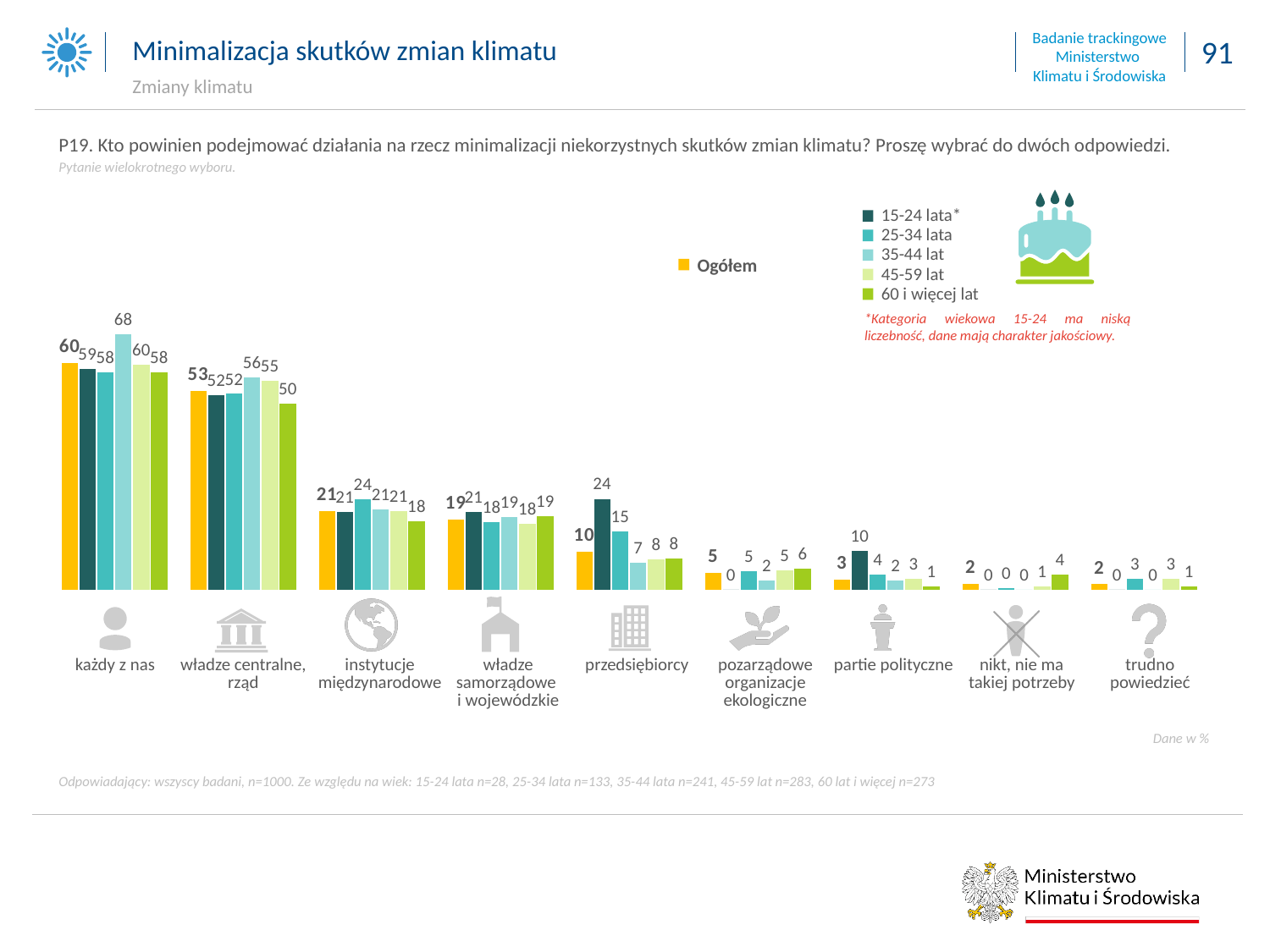
Which is larger: the 15-24 lata value for "przedsiębiorcy" or the Ogółem value for "przedsiębiorcy"? 15-24 lata What is the value for the 35-44 lat group in the "każdy z nas" category? 68 What type of chart is shown on the slide? bar chart How many series does the legend list in total (including Ogółem)? 6 Which age group has the lowest value in the "władze centralne, rząd" category? 60 i więcej lat Which age group is marked with an asterisk in the legend as having a low sample size? 15-24 lata What is the difference between the Ogółem values for "każdy z nas" and "władze centralne, rząd"? 7 What is the value for the 15-24 lata group in the "partie polityczne" category? 10 Which category has the highest Ogółem value? każdy z nas What is the value for the 15-24 lata group in the "przedsiębiorcy" category? 24 What is the Ogółem value for "każdy z nas"? 60 How many response categories are shown on the x axis? 9